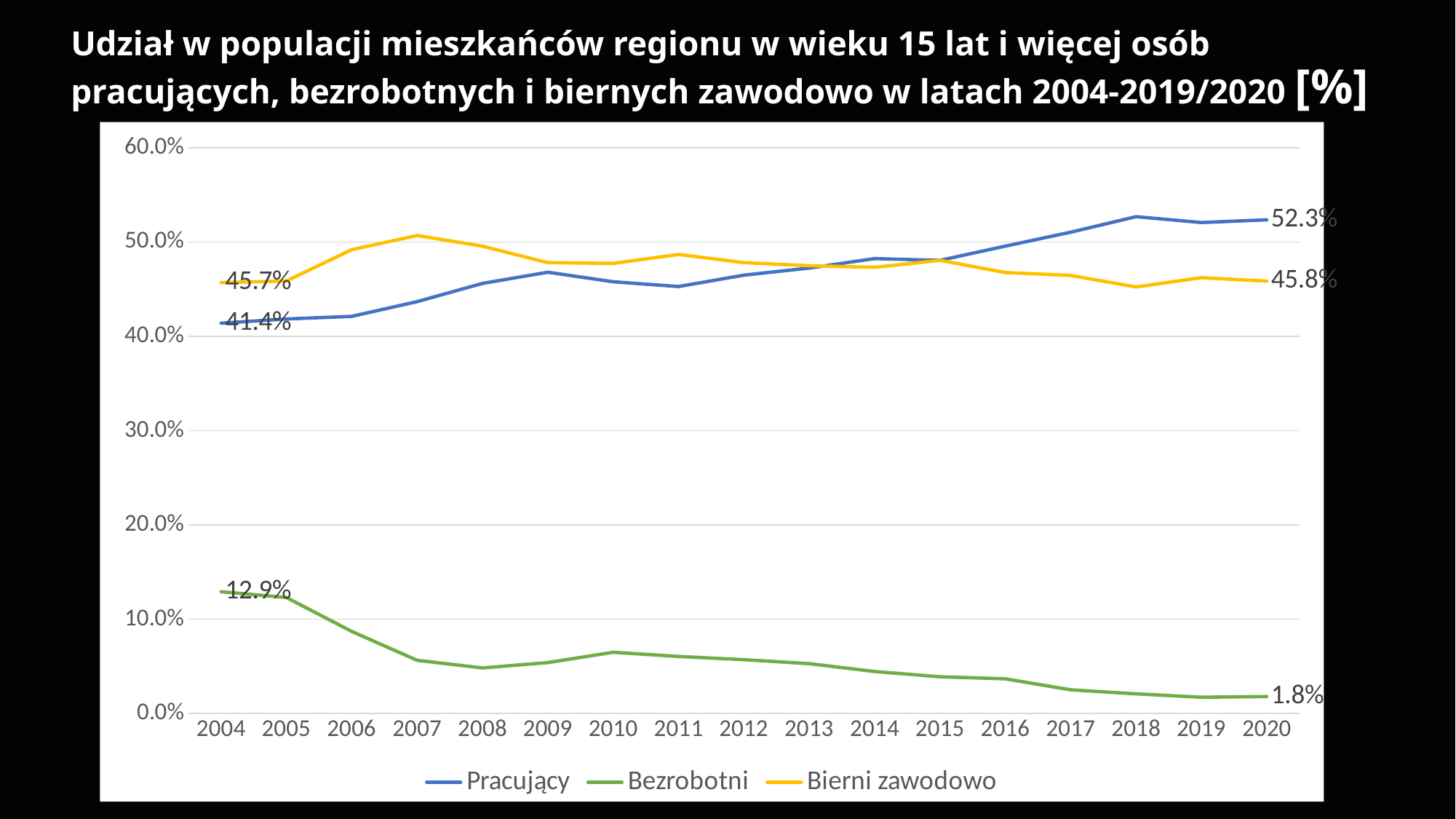
How many series does the legend list? 3 How many years are shown on the x axis? 17 What is the value for Bezrobotni in 2020? 1.8% What is the value for Bierni zawodowo in 2020? 45.8% What is the value for Pracujący in 2004? 41.4% What type of chart is shown on the slide? line chart What is the value for Pracujący in 2020? 52.3% Which series has the lowest value in 2020? Bezrobotni Does the Bezrobotni series rise or fall from 2004 to 2020? fall Is the value for Bierni zawodowo in 2007 greater or less than 50.0%? greater What is the value for Bezrobotni in 2004? 12.9% By how many percentage points did Pracujący change from 2004 to 2020? 10.9 percentage points